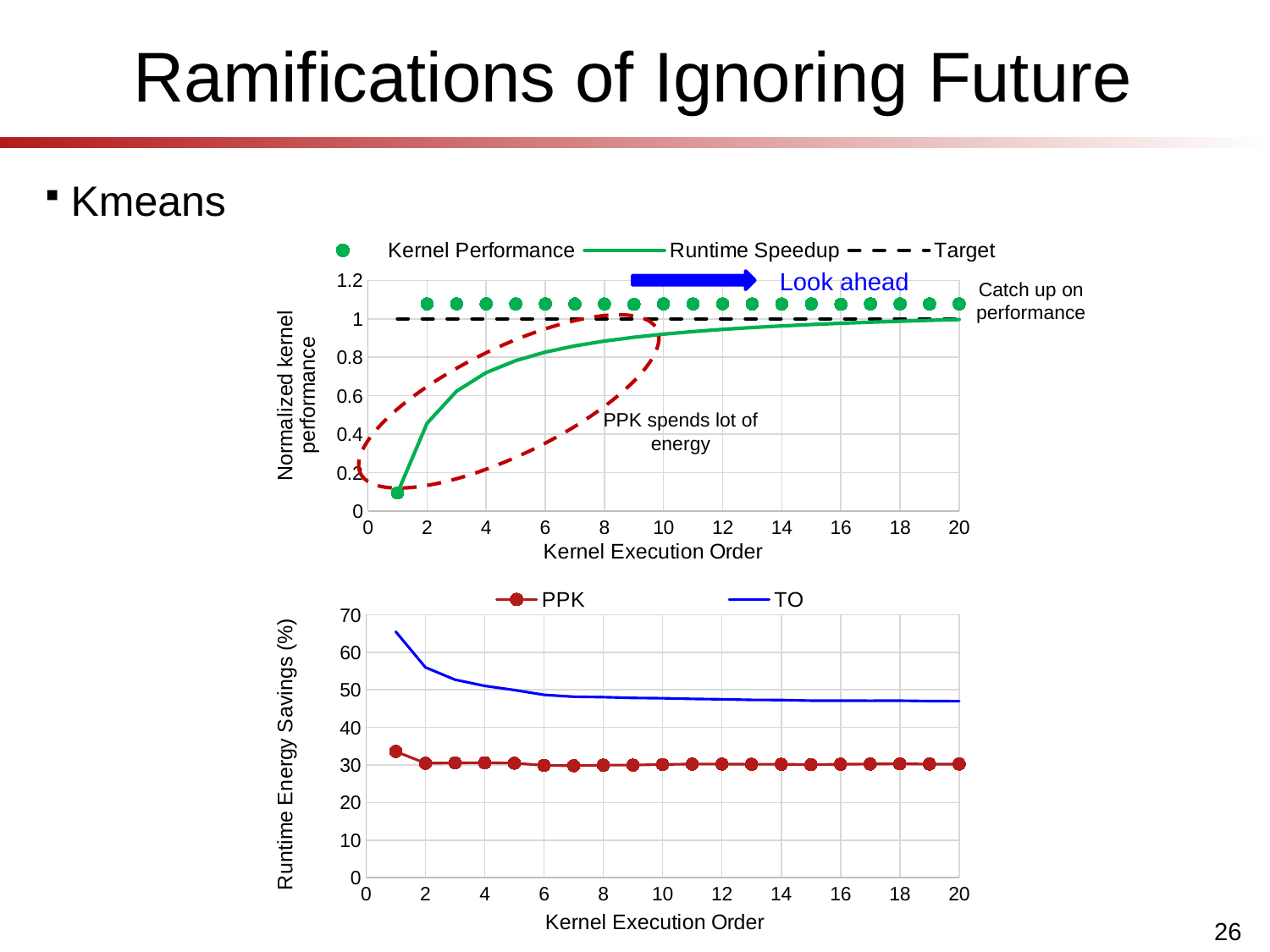
In the top chart, is the Kernel Performance value at kernel execution order 2 greater or less than 1? greater In the top chart, does the Runtime Speedup series rise or fall as Kernel Execution Order increases? rise In the bottom chart, is the TO value at kernel execution order 1 greater or less than 60? greater What is the y-axis label of the bottom chart? Runtime Energy Savings (%) In the top chart, is the Runtime Speedup value at kernel execution order 1 greater or less than 0.2? less What kind of chart is the bottom chart (Runtime Energy Savings)? line chart In the top chart (Normalized kernel performance), how many series does the legend list? 3 In the bottom chart (Runtime Energy Savings), how many series does the legend list? 2 In the top chart, at kernel execution order 2, which is larger, Kernel Performance or Runtime Speedup? Kernel Performance In the bottom chart, at kernel execution order 10, which series has the larger value, PPK or TO? TO In the bottom chart, does the TO series rise or fall as Kernel Execution Order increases? fall